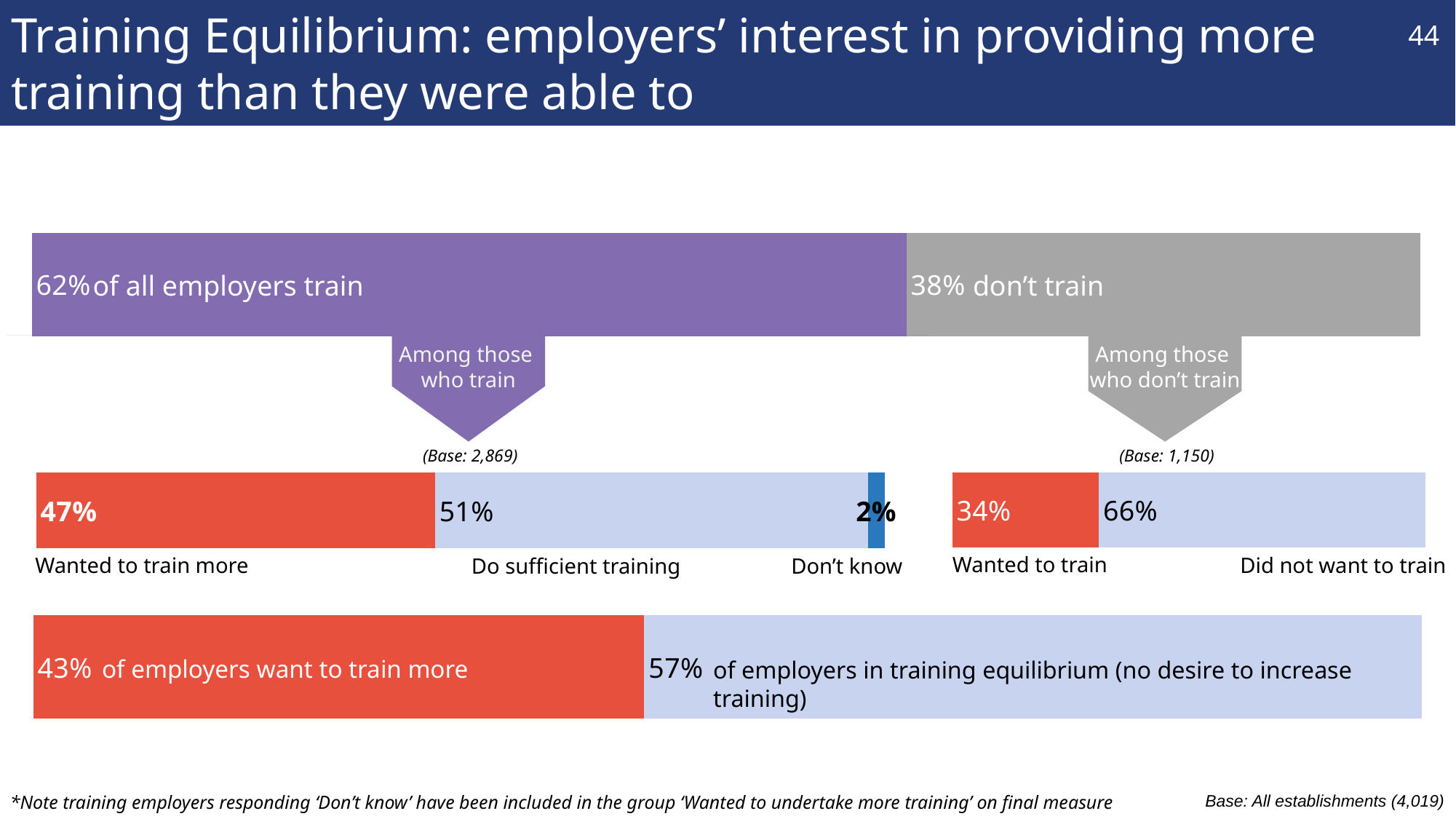
In the 'Among those who train' bar, what percentage do sufficient training? 51% How many segments does the 'Among those who train' bar have? 3 In the top bar, what percentage of all employers train? 62% In the 'Among those who train' bar, what percentage wanted to train more? 47% In the bottom bar, what percentage of employers are in training equilibrium? 57% In the 'Among those who train' bar, what percentage answered 'Don't know'? 2% In the top bar, what percentage of employers don't train? 38% In the 'Among those who don't train' bar, what is the difference between 'Did not want to train' and 'Wanted to train'? 32% In the 'Among those who don't train' bar, what percentage wanted to train? 34% In the 'Among those who don't train' bar, which category is larger: 'Wanted to train' or 'Did not want to train'? Did not want to train In the 'Among those who train' bar, which category has the smallest share? Don't know In the bottom bar, what percentage of employers want to train more? 43%